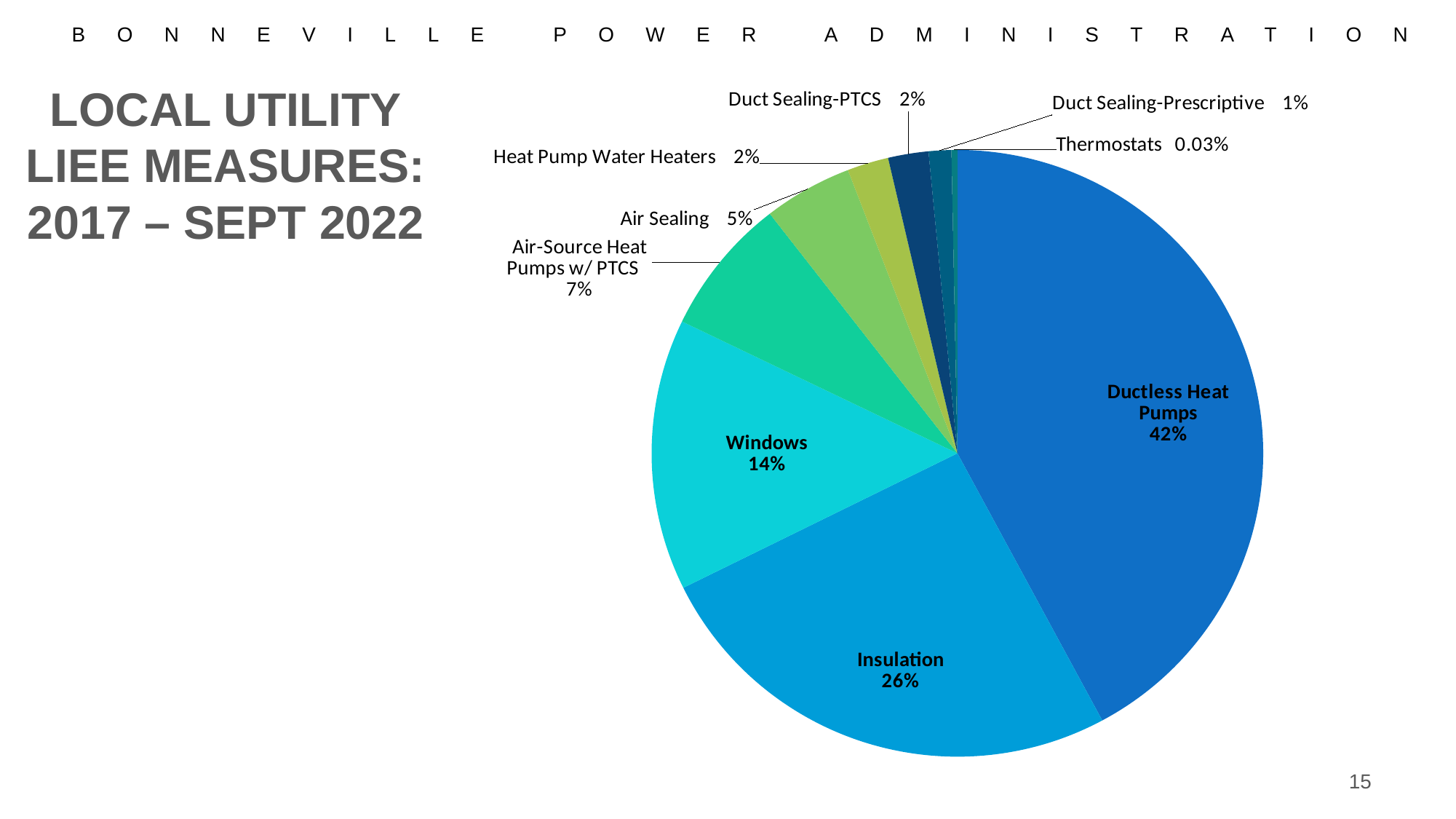
What share of the pie does Ductless Heat Pumps represent? 42% What is the title of the slide containing the chart? LOCAL UTILITY LIEE MEASURES: 2017 – SEPT 2022 What type of chart is shown on the slide? Pie chart What is the difference between the Ductless Heat Pumps share and the Insulation share? 16% How many categories are shown in the pie chart? 9 What is the value shown for Insulation? 26% Which category has the largest slice of the pie? Ductless Heat Pumps Which category has the smallest slice of the pie? Thermostats Which is larger, the Windows slice or the Air Sealing slice? Windows What is the value shown for Thermostats? 0.03% What is the value shown for Air-Source Heat Pumps w/ PTCS? 7% What is the value shown for Windows? 14%